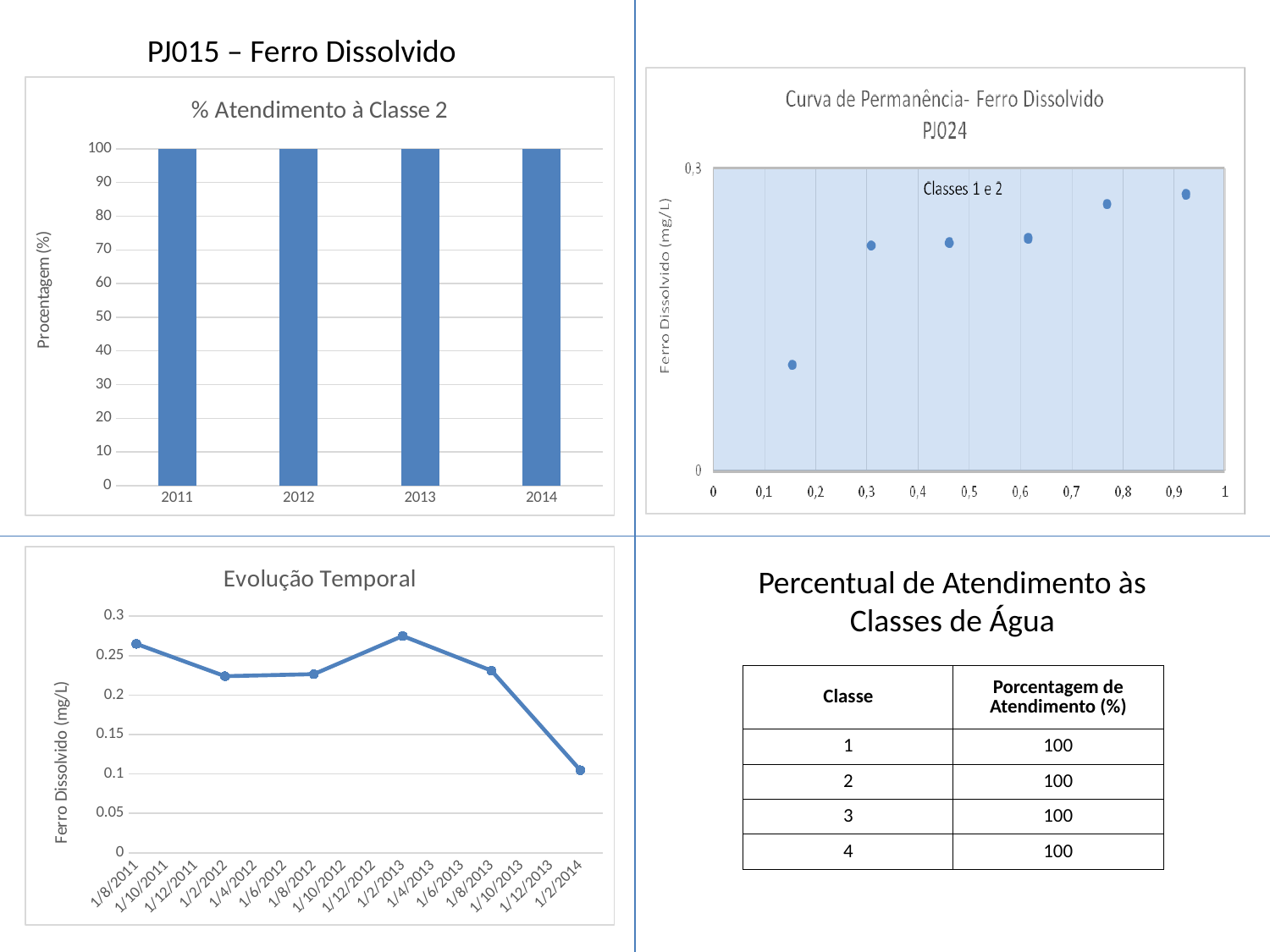
How many data points are plotted in the 'Evolução Temporal' chart? 6 What kind of chart is 'Curva de Permanência- Ferro Dissolvido PJ024'? scatter chart In the 'Evolução Temporal' chart, which is larger: the value for 1/2/2013 or the value for 1/2/2014? 1/2/2013 In the '% Atendimento à Classe 2' chart, what is the value for 2013? 100 In the 'Evolução Temporal' chart, is the value for 1/2/2014 greater or less than 0.15? less How many years are shown in the '% Atendimento à Classe 2' chart? 4 How many data points are plotted in the 'Curva de Permanência- Ferro Dissolvido PJ024' chart? 6 What is the y-axis label of the '% Atendimento à Classe 2' chart? Procentagem (%) What kind of chart is '% Atendimento à Classe 2'? bar chart In the 'Evolução Temporal' chart, which date has the lowest value? 1/2/2014 In the '% Atendimento à Classe 2' chart, is the value for 2012 greater or less than 50? greater In the 'Curva de Permanência- Ferro Dissolvido PJ024' chart, do the values rise or fall as you move along the x axis? rise